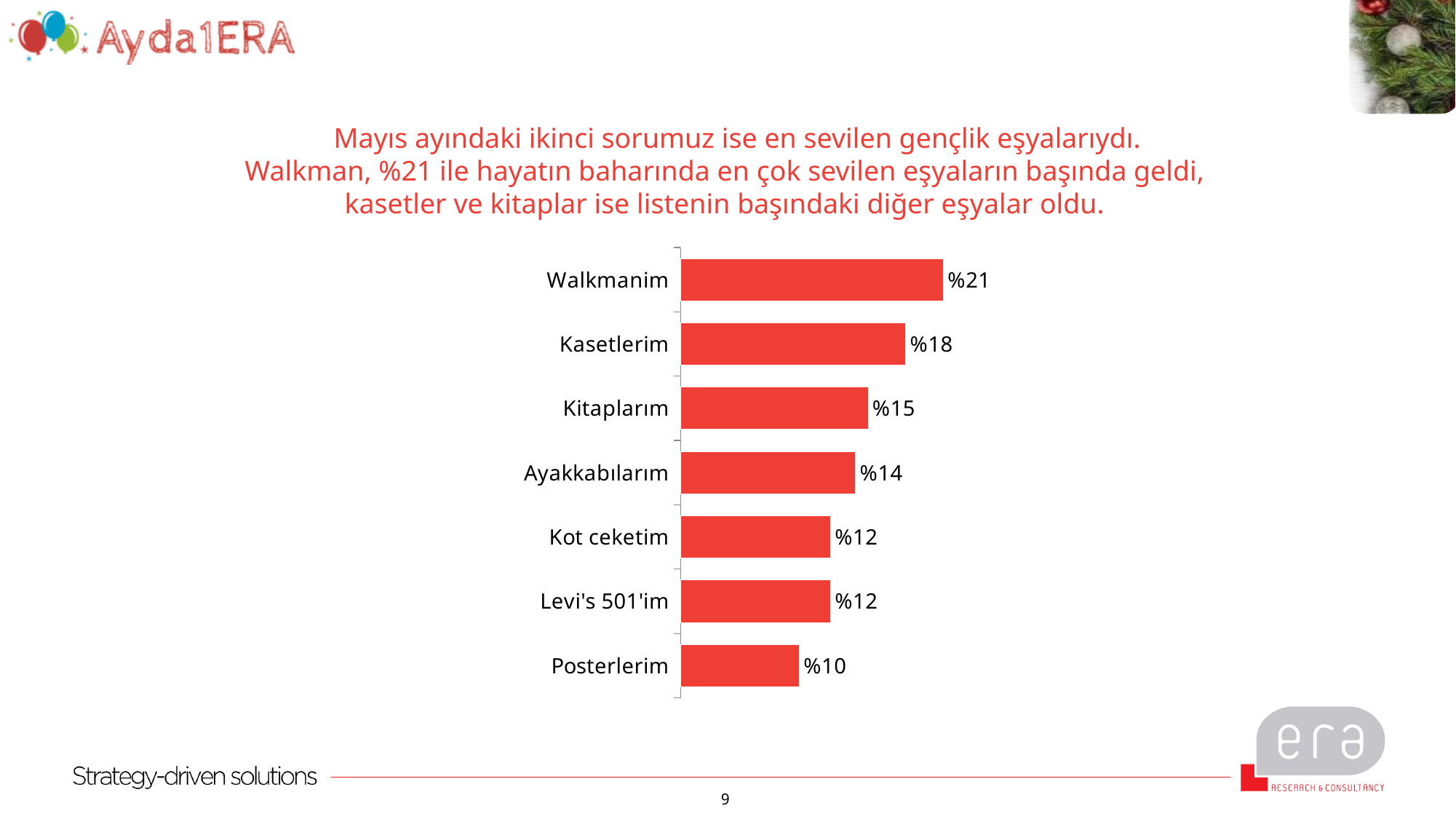
What is the value for Kasetlerim? %18 Which category has the lowest value? Posterlerim How many categories are shown in the chart? 7 What is the value for Walkmanim? %21 What kind of chart is shown on the slide? Bar chart What is the value for Posterlerim? %10 What is the difference between the values for Walkmanim and Kitaplarım? %6 What colour are the bars in the chart? Red Which is larger, the value for Kitaplarım or the value for Kot ceketim? Kitaplarım What is the value for Ayakkabılarım? %14 What is the difference between the values for Kasetlerim and Posterlerim? %8 Which category has the highest value? Walkmanim